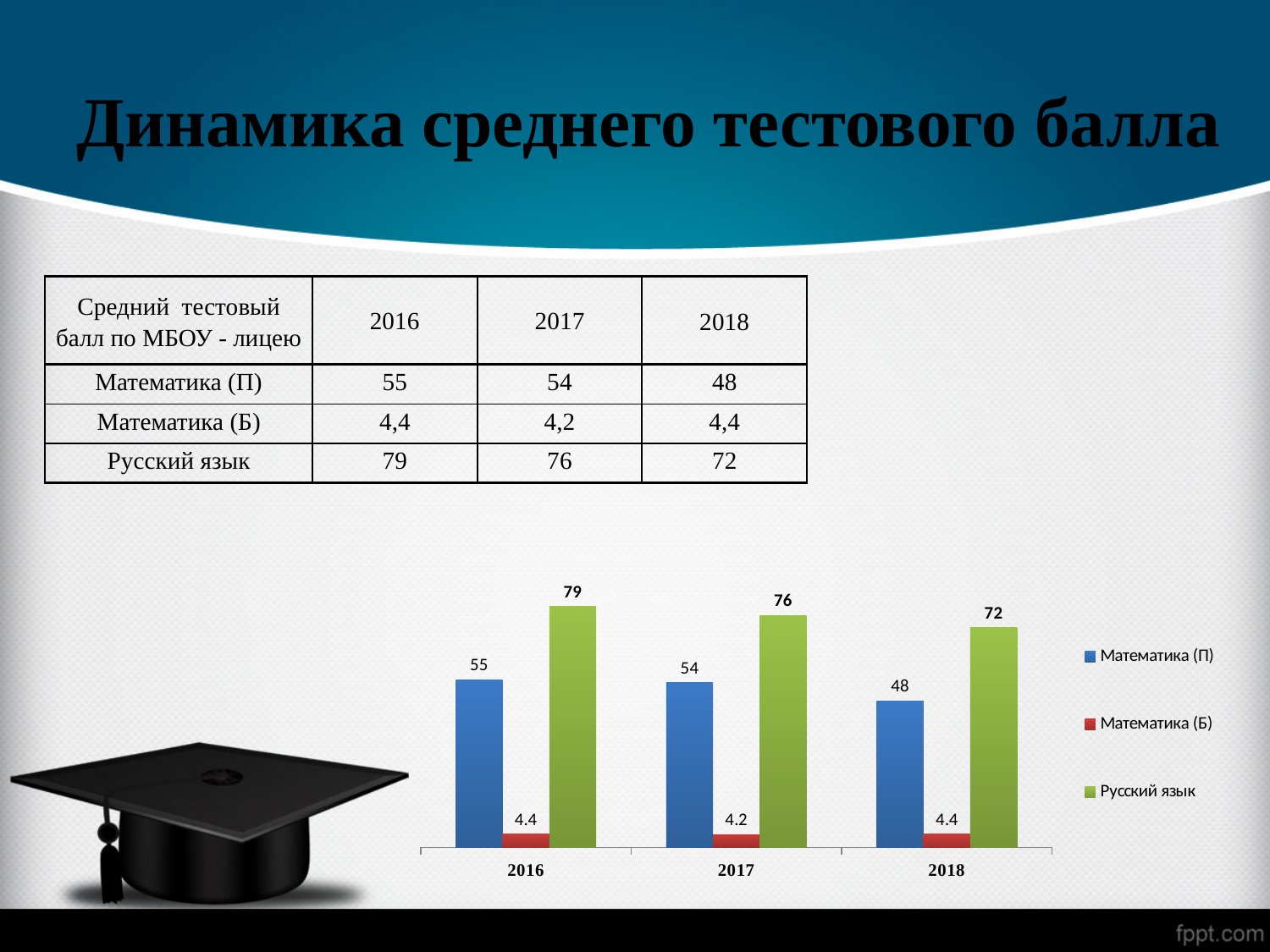
What is the difference between the Русский язык values for 2016 and 2018? 7 What is the value for Русский язык in 2018? 72 In which year is the Математика (П) value lowest? 2018 Which is larger: Математика (П) in 2017 or Математика (П) in 2018? Математика (П) in 2017 In which year is the Русский язык value highest? 2016 How many year categories are shown on the x axis of the chart? 3 What is the value for Математика (Б) in 2017? 4.2 Do the Русский язык values rise or fall from 2016 to 2018? fall Which colour represents Русский язык in the chart legend? green What type of chart is shown on the slide? bar chart How many series does the chart legend list? 3 What is the value for Математика (П) in 2016? 55